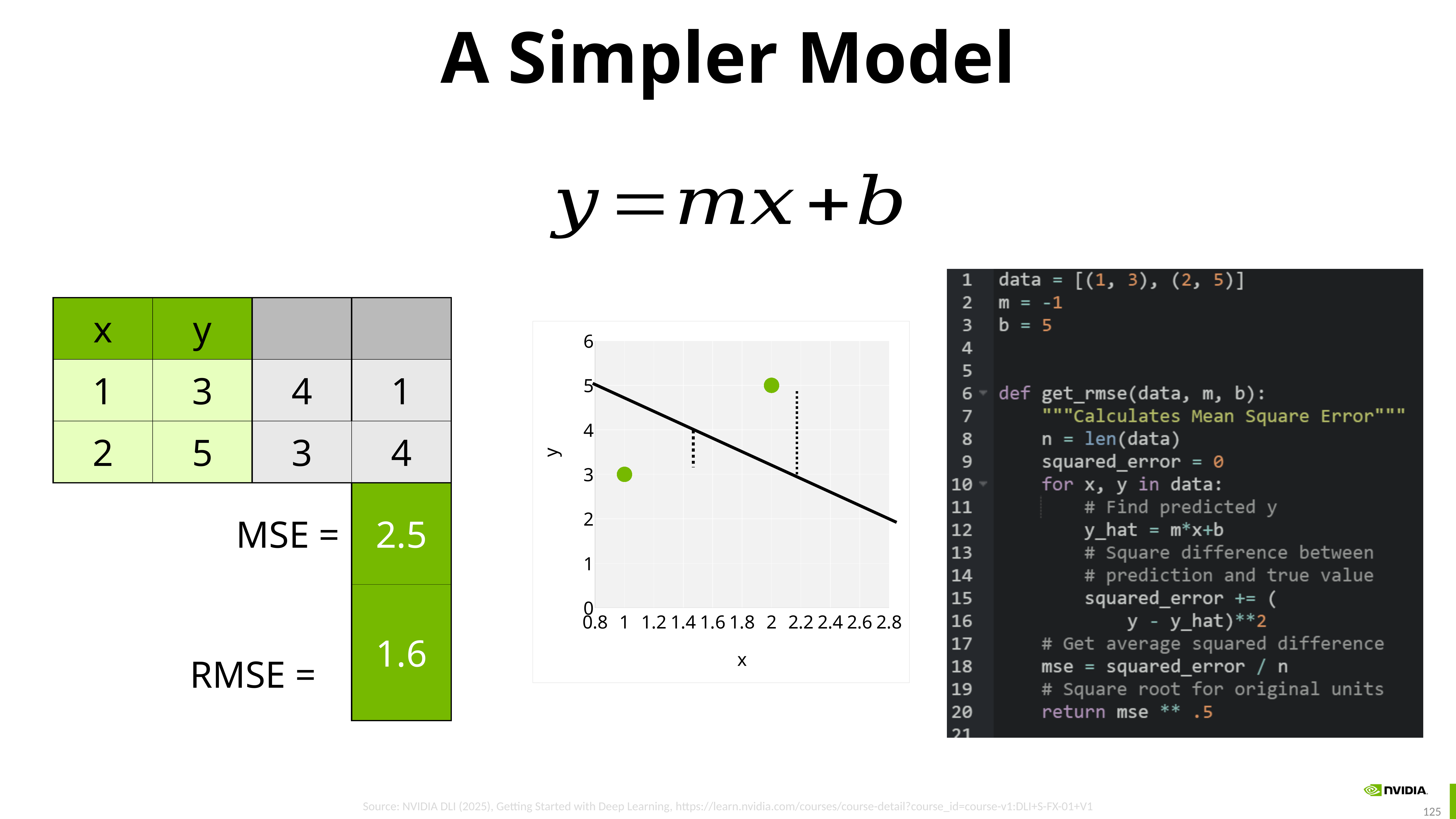
How many data points are plotted on the scatter chart? 2 On the scatter chart, what is the difference in y between the point at x = 2 and the point at x = 1? 2 Does the fitted line on the scatter chart rise or fall as x increases? fall On the scatter chart, is the y value of the point at x = 2 greater or less than 4? greater On the scatter chart, is the y value of the point at x = 1 greater or less than 4? less Do the plotted points on the scatter chart rise or fall as x increases? rise What kind of chart is shown in the middle of the slide? scatter chart What label is shown on the x axis of the scatter chart? x On the scatter chart, which plotted point has the higher y value, the one at x = 1 or the one at x = 2? the one at x = 2 On the scatter chart, what is the y value of the point at x = 2? 5 On the scatter chart, what is the y value of the point at x = 1? 3 What is the maximum value shown on the y axis of the scatter chart? 6